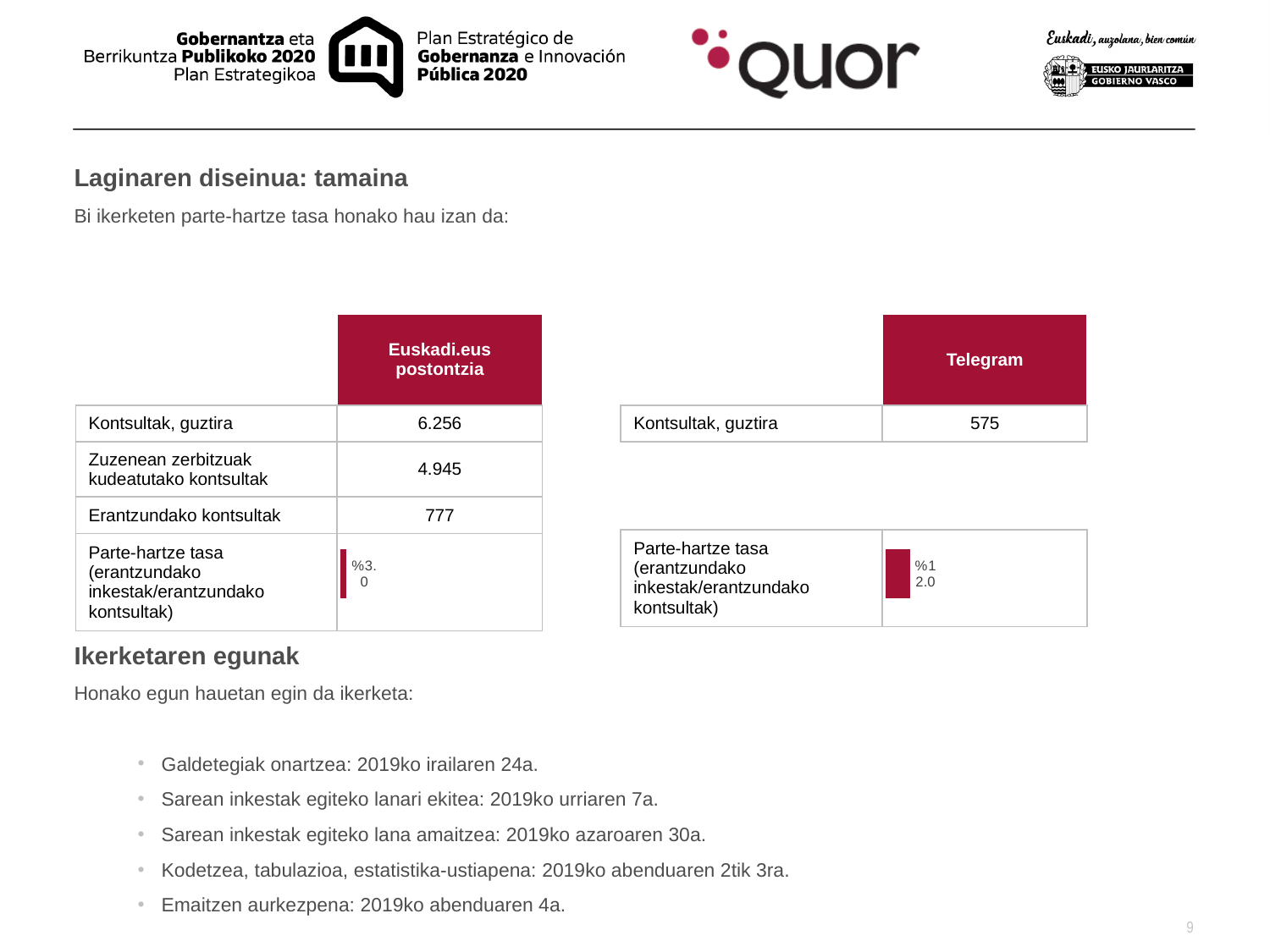
Which participation-rate bar is larger, the one for Euskadi.eus postontzia or the one for Telegram? Telegram In the Telegram table, what participation rate (Parte-hartze tasa) does the small bar chart show? %12.0 In the Euskadi.eus postontzia table, what participation rate (Parte-hartze tasa) does the small bar chart show? %3.0 What kind of chart is used to show the participation rate in the Euskadi.eus postontzia table? bar chart What is the difference between the Telegram participation rate and the Euskadi.eus postontzia participation rate shown in the bar charts? 9.0 percentage points What colour are the participation-rate bars in both tables? dark red How many bars does the participation-rate chart in the Telegram table contain? 1